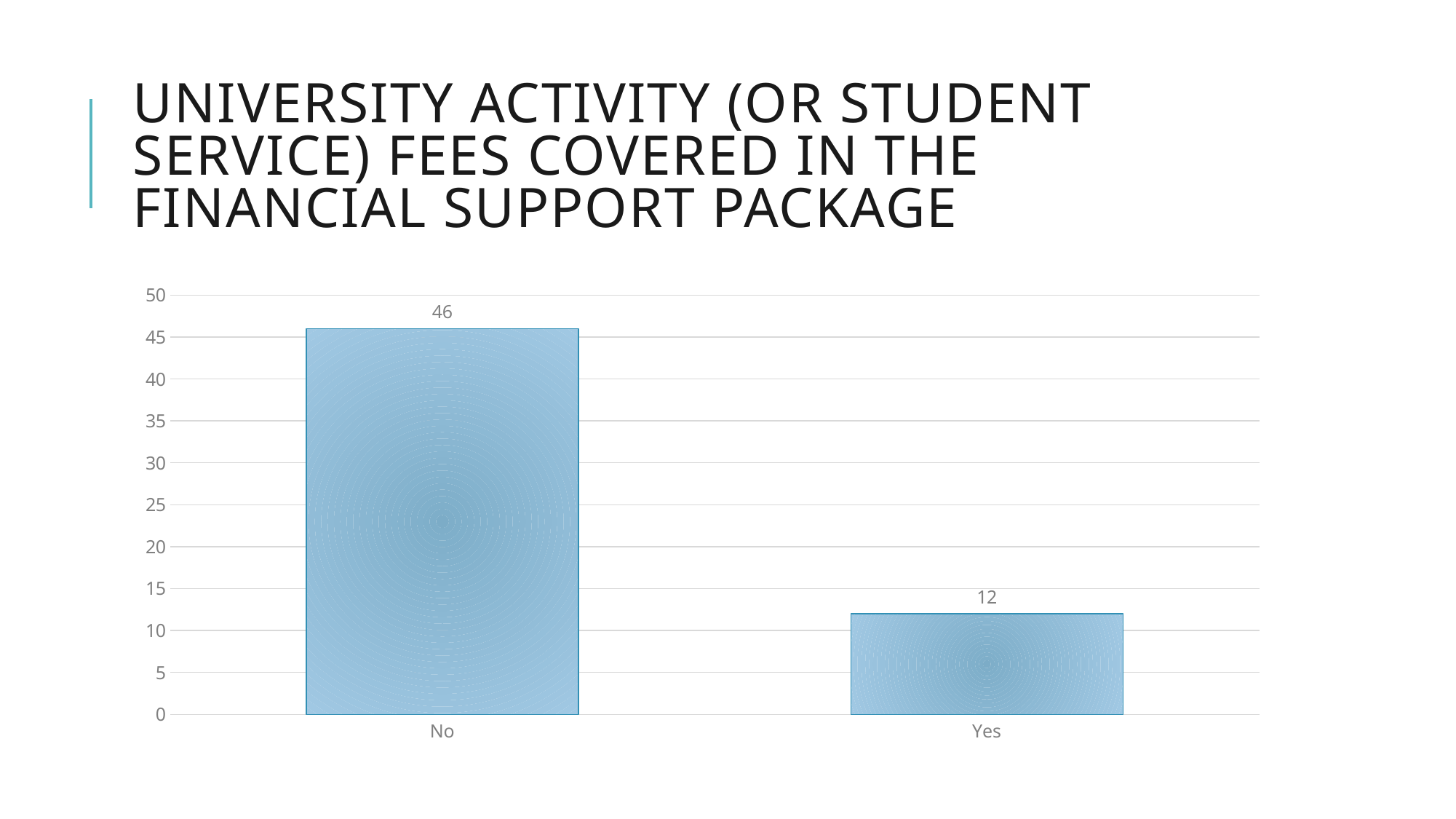
What is the value for "Yes"? 12 Which is larger, the value for "No" or the value for "Yes"? No Which category has the highest value? No How many categories are shown on the x axis? 2 Is the value for "No" greater or less than 40? greater What kind of chart is shown on the slide? bar chart Which category has the lowest value? Yes What is the maximum value shown on the y axis? 50 Is the value for "Yes" greater or less than 15? less What is the value for "No"? 46 What is the total of the two bars combined? 58 What is the difference between the values for "No" and "Yes"? 34